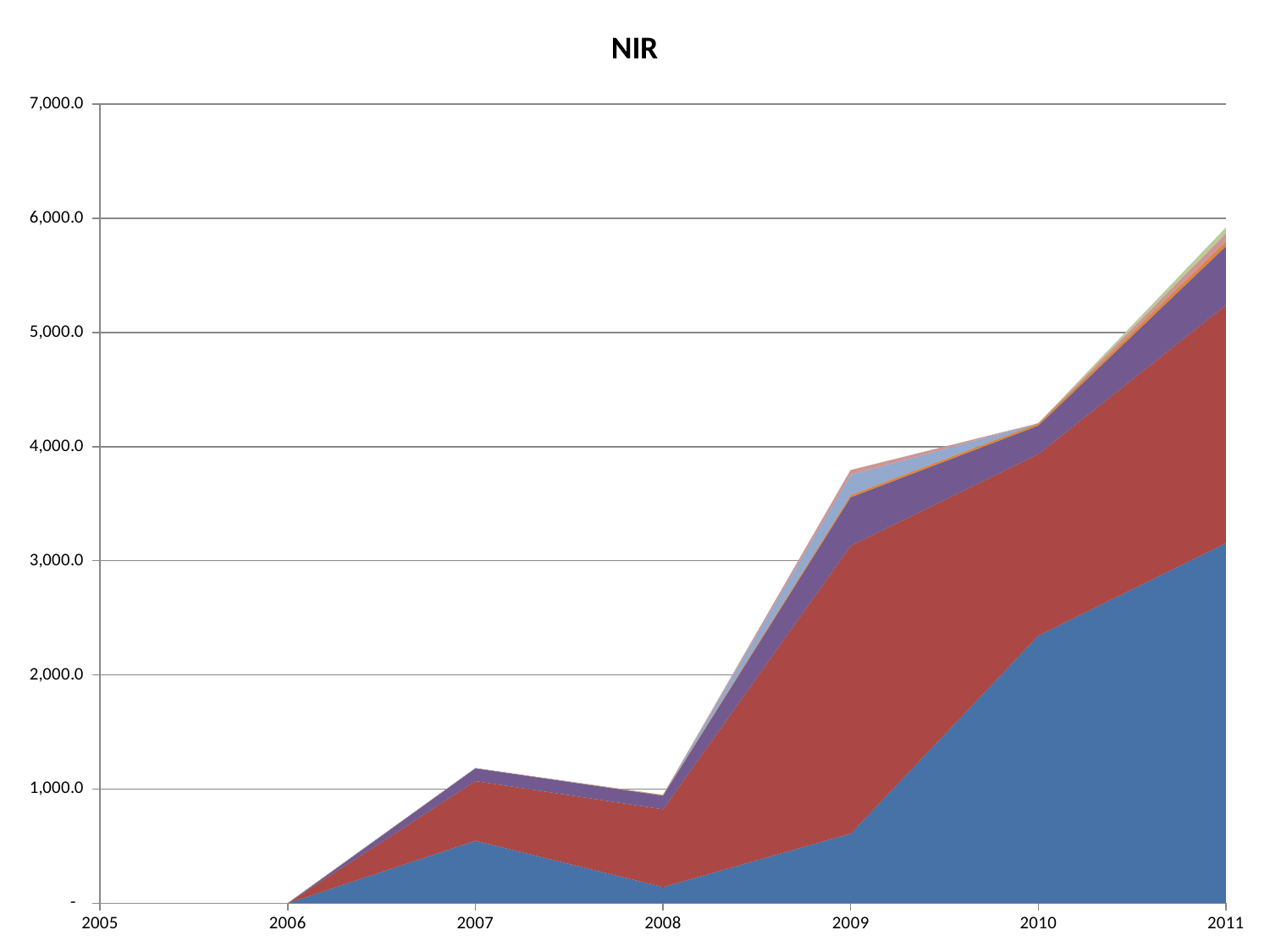
What is the highest value shown on the y axis of the chart? 7,000.0 What kind of chart is shown on the slide? Stacked area chart Overall, do the stacked totals rise or fall from 2006 to 2011? rise Is the value of the bottom (blue) series in 2010 greater or less than 2,000.0? greater In which year does the stacked total reach its highest value? 2011 Is the stacked total for 2010 greater or less than 4,000.0? greater Is the stacked total for 2011 greater or less than 5,000.0? greater How many years are labelled on the x axis of the chart? 7 Which year has the larger stacked total, 2007 or 2008? 2007 What is the title of the chart? NIR